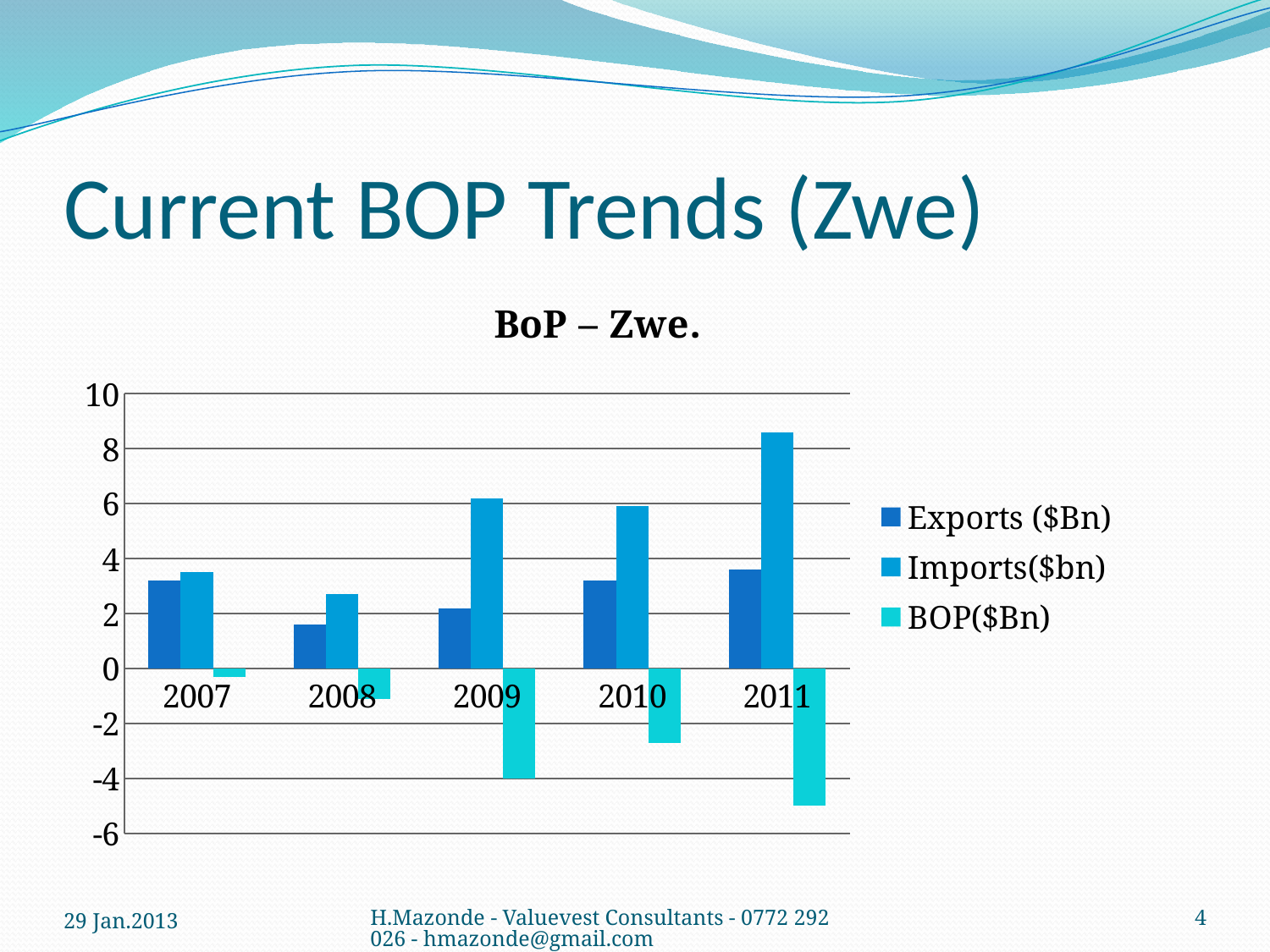
How many years are shown on the x axis? 5 Which is larger in 2009, Exports ($Bn) or Imports($bn)? Imports($bn) What is the title of the chart? BoP – Zwe. Which year has a larger Imports($bn) value, 2008 or 2010? 2010 Is the Exports ($Bn) value for 2008 greater or less than 2? less What kind of chart is shown on the slide? bar chart Is the BOP($Bn) value for 2010 greater or less than -2? less Which year has the highest Imports($bn) value? 2011 How many series does the legend list? 3 Which year has the lowest Exports ($Bn) value? 2008 Which year has the lowest BOP($Bn) value? 2011 Is the Imports($bn) value for 2011 greater or less than 8? greater